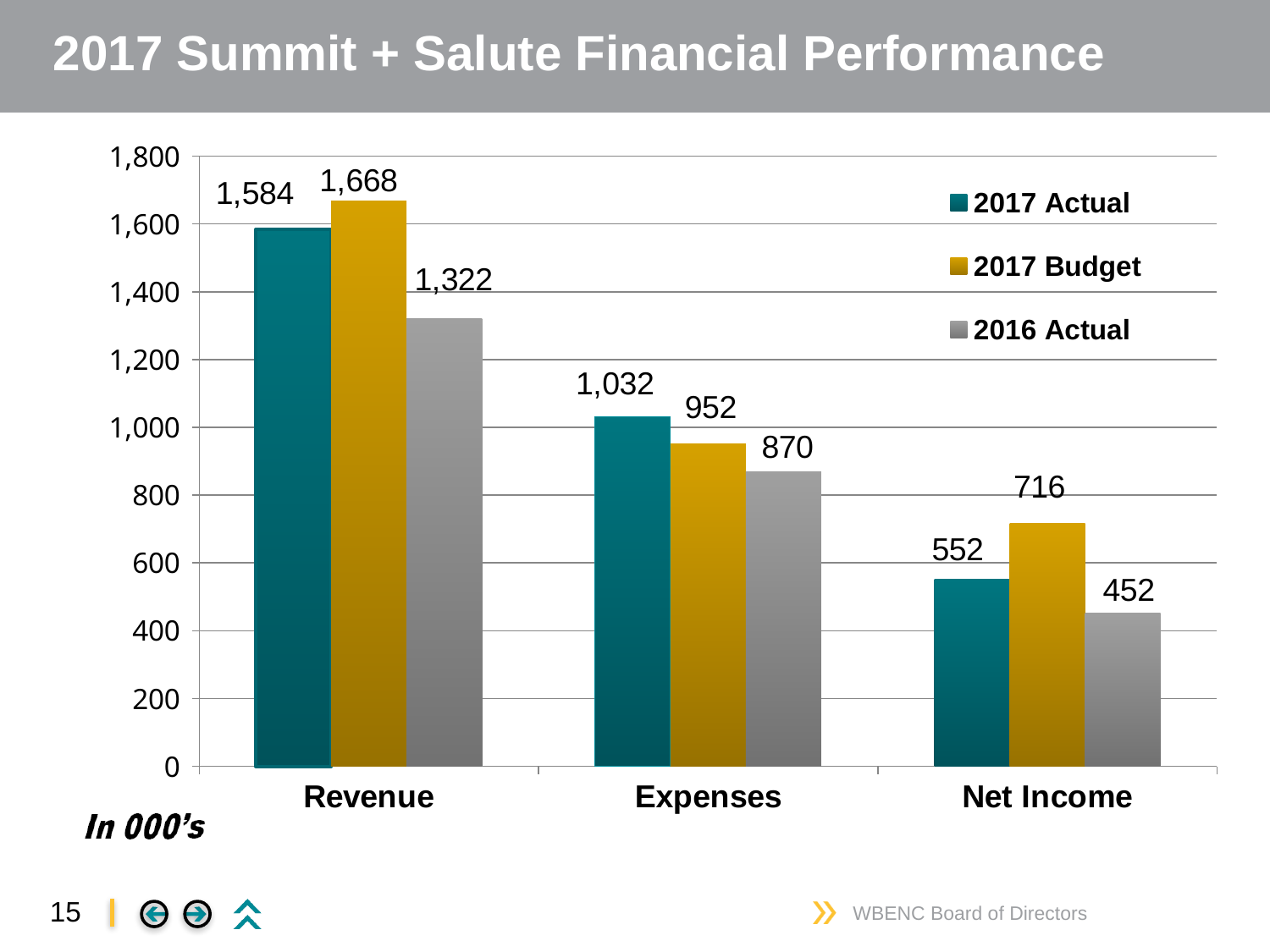
What unit note is shown below the chart? In 000's What is the difference between the 2017 Actual and 2016 Actual values for Net Income? 100 Which is larger for Expenses: 2017 Actual or 2017 Budget? 2017 Actual What is the 2017 Actual value for Revenue? 1,584 What is the 2017 Budget value for Net Income? 716 How many categories are shown on the x axis? 3 Which category has the highest 2017 Budget value? Revenue What is the 2016 Actual value for Expenses? 870 How many series does the legend list? 3 What is the difference between the 2017 Budget and 2017 Actual values for Revenue? 84 Which category has the lowest 2016 Actual value? Net Income What kind of chart is shown on the slide? Bar chart